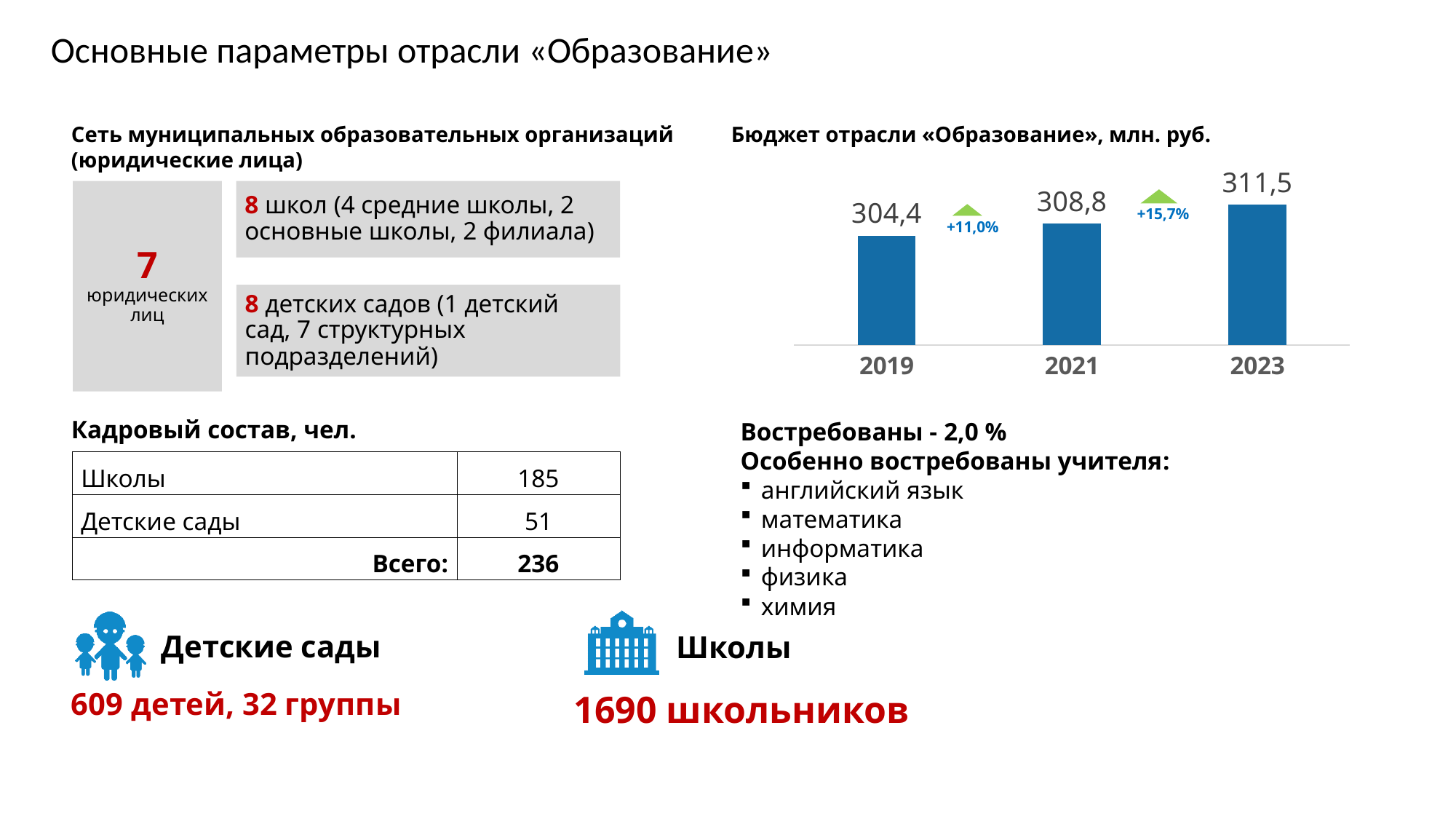
Do the budget values rise or fall from 2019 to 2023 in the chart? rise What kind of chart is used to show the budget of the «Образование» sector? bar chart What is the difference between the 2021 and 2019 budget values in the chart? 4,4 What is the budget value shown for 2023 in the chart? 311,5 Which is larger in the chart, the budget value for 2021 or for 2023? 2023 What is the budget value shown for 2019 in the chart «Бюджет отрасли «Образование», млн. руб.»? 304,4 Which year has the lowest budget value in the chart? 2019 Which year has the highest budget value in the chart? 2023 What is the difference between the 2023 and 2019 budget values in the chart? 7,1 What is the budget value shown for 2021 in the chart? 308,8 What percentage change is annotated between the 2021 and 2023 bars in the chart? +15,7% How many years (bars) are shown in the budget chart? 3